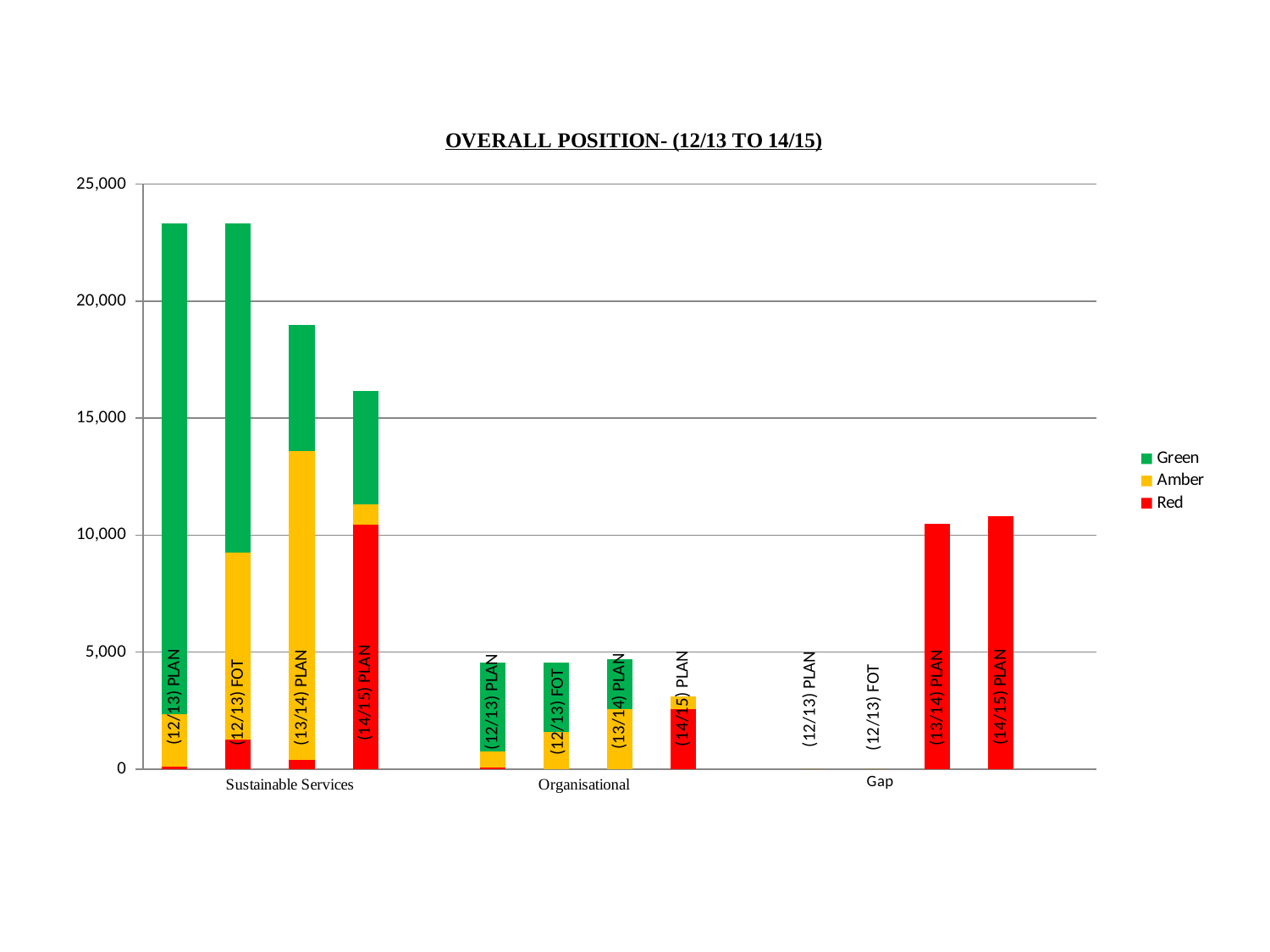
Which is larger: the total for Sustainable Services (13/14) PLAN or Sustainable Services (14/15) PLAN? Sustainable Services (13/14) PLAN Is the value for Gap (13/14) PLAN greater or less than 10,000? greater Is the total value for Sustainable Services (13/14) PLAN greater or less than 20,000? less Is the total value for Organisational (12/13) PLAN greater or less than 5,000? less How many category groups are shown along the x axis? 3 What is the title of the chart? OVERALL POSITION- (12/13 TO 14/15) How many series does the legend list? 3 Within the Sustainable Services group, which bar has the lowest total? (14/15) PLAN How many bars are plotted in the Sustainable Services group? 4 Do the bar totals in the Gap group rise or fall from (12/13) PLAN to (14/15) PLAN? Rise What kind of chart is shown on the slide? Stacked bar chart